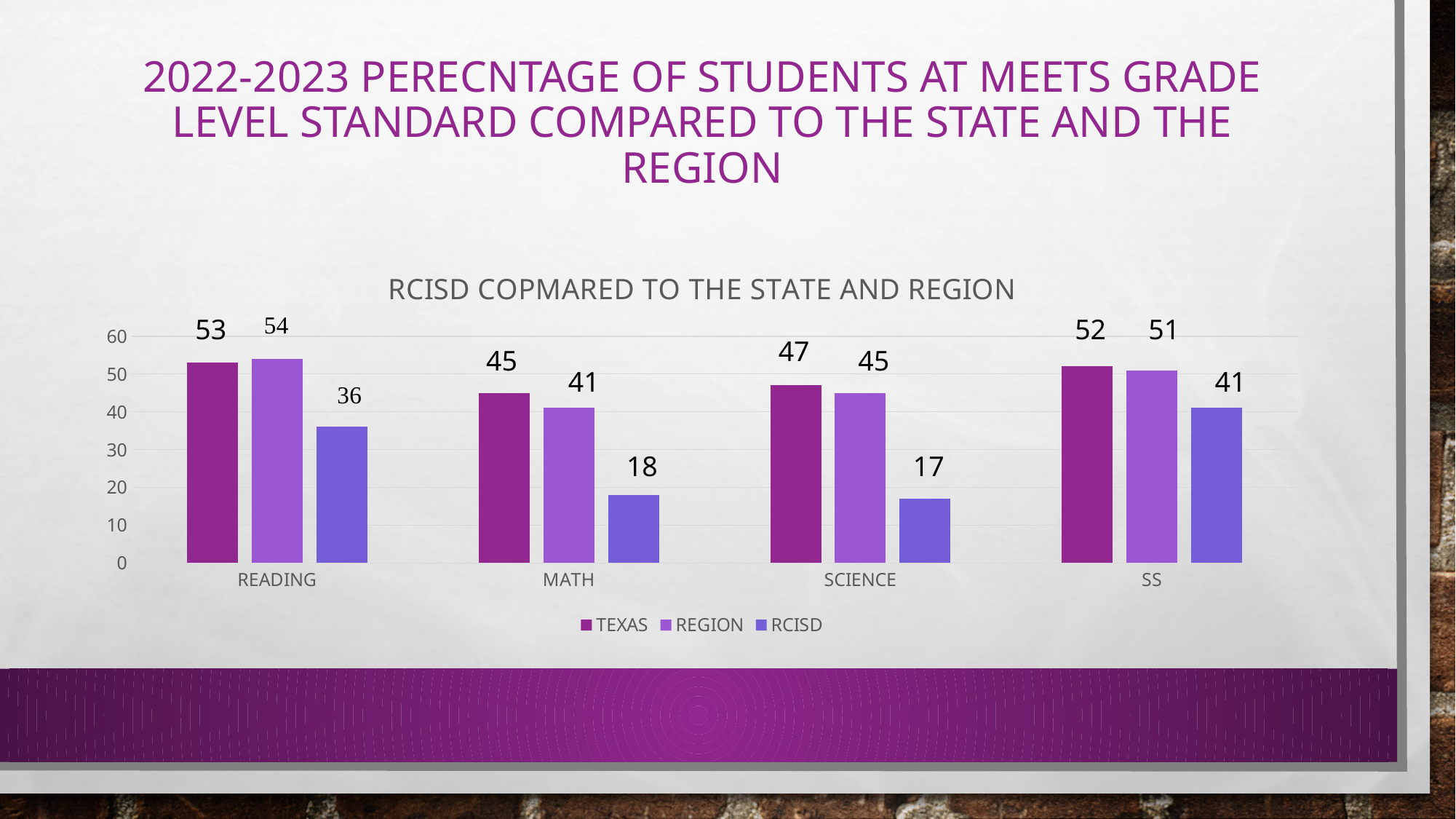
What is the difference between the Region and RCISD values in SS? 10 What kind of chart is shown on the slide? Bar chart Which subject has the highest Region value? Reading How many subject categories are shown on the x axis? 4 What is the title of the chart? RCISD COPMARED TO THE STATE AND REGION How many series does the legend list? 3 Which subject has the lowest RCISD value? Science What is the value for Region in SS? 51 Which is larger in Reading, the Texas value or the Region value? Region What is the difference between the Texas and RCISD values in Math? 27 What is the value for Texas in Science? 47 What is the value for RCISD in Reading? 36